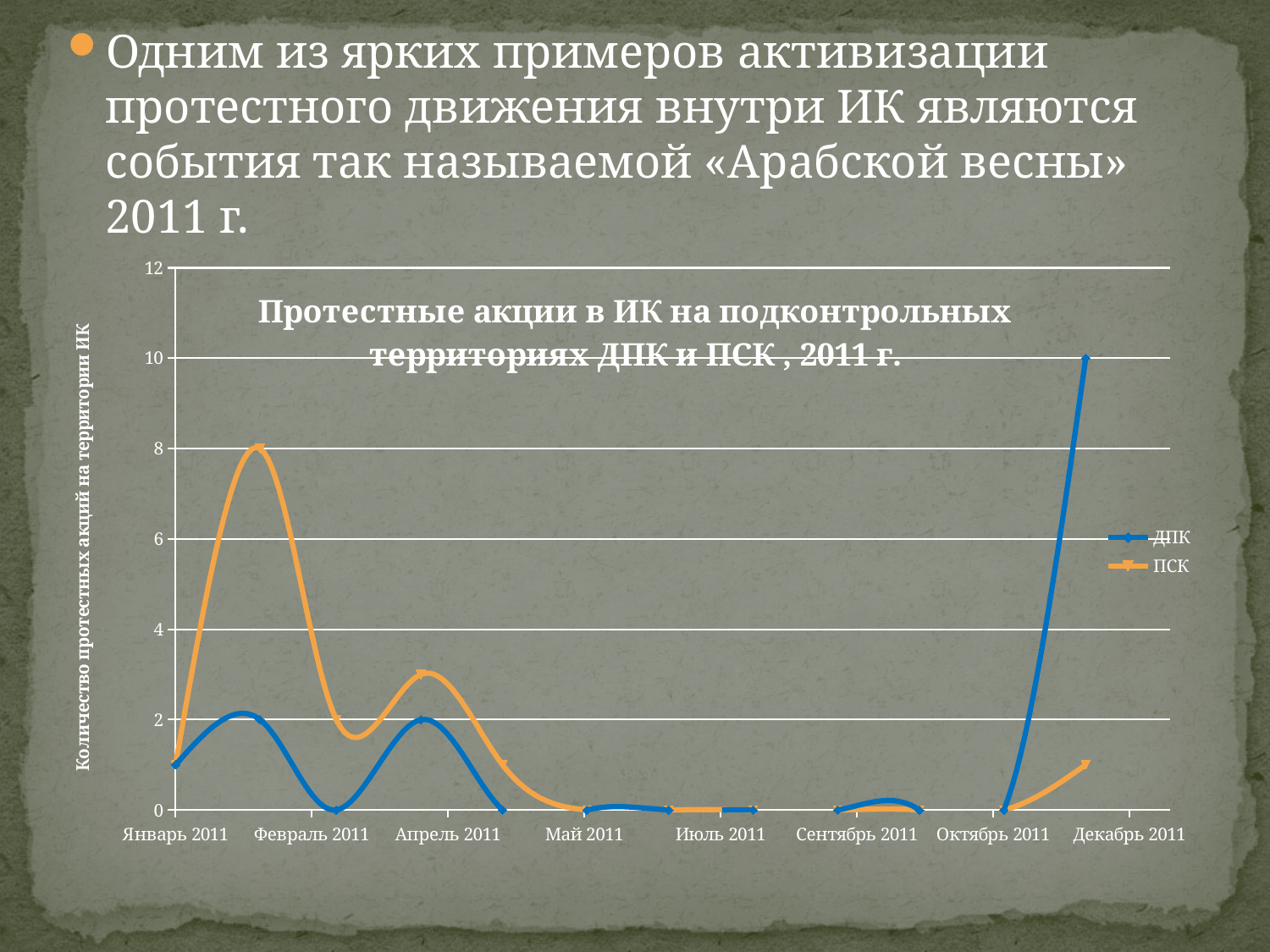
What is the difference between the ДПК value in Декабрь 2011 and the ПСК value in Февраль 2011? 2 What is the value for ДПК in Декабрь 2011? 10 What is the value for ПСК in Февраль 2011? 8 In Февраль 2011, which series has the larger value, ДПК or ПСК? ПСК What type of chart is shown on the slide? Line chart How many series does the chart legend list? 2 In which month does the ПСК series reach its highest value? Февраль 2011 Is the value for ПСК in Апрель 2011 greater or less than 2? greater What is the value for ДПК in Апрель 2011? 2 Which series is drawn in orange? ПСК In which month does the ДПК series reach its highest value? Декабрь 2011 What is the title of the chart? Протестные акции в ИК на подконтрольных территориях ДПК и ПСК , 2011 г.